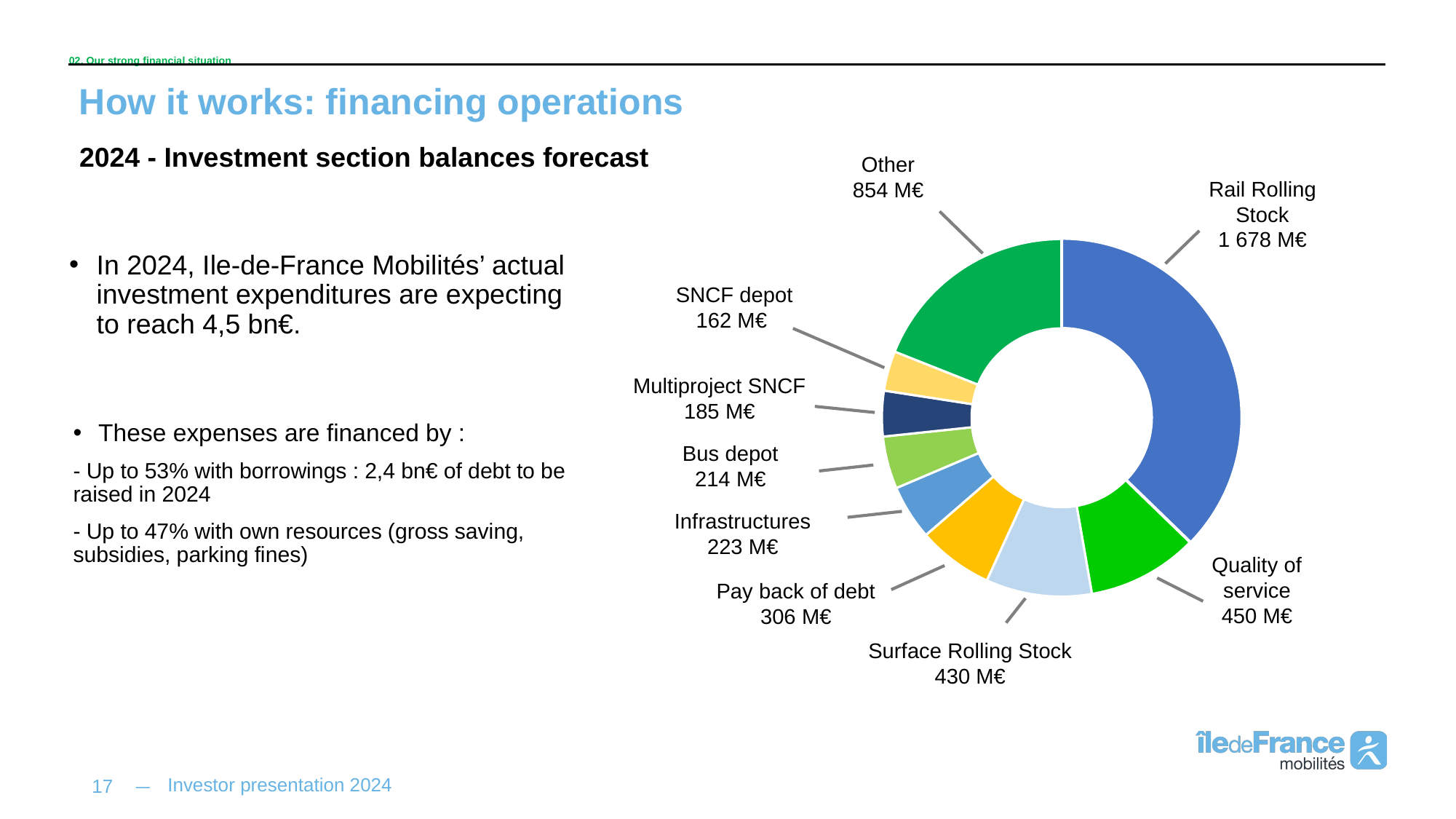
What is the difference between Other and Pay back of debt? 548 M€ What is the value for Rail Rolling Stock in the 2024 investment section balances forecast chart? 1 678 M€ What is the value for Surface Rolling Stock? 430 M€ Which category has the largest value in the chart? Rail Rolling Stock What is the difference between Quality of service and Surface Rolling Stock? 20 M€ What kind of chart is shown on the slide? doughnut (pie) chart Which is larger, Bus depot or Multiproject SNCF? Bus depot What is the value for Pay back of debt? 306 M€ What is the total of all the values shown in the chart? 4 502 M€ What is the value for SNCF depot? 162 M€ Which category has the smallest value in the chart? SNCF depot How many categories are shown in the chart? 9